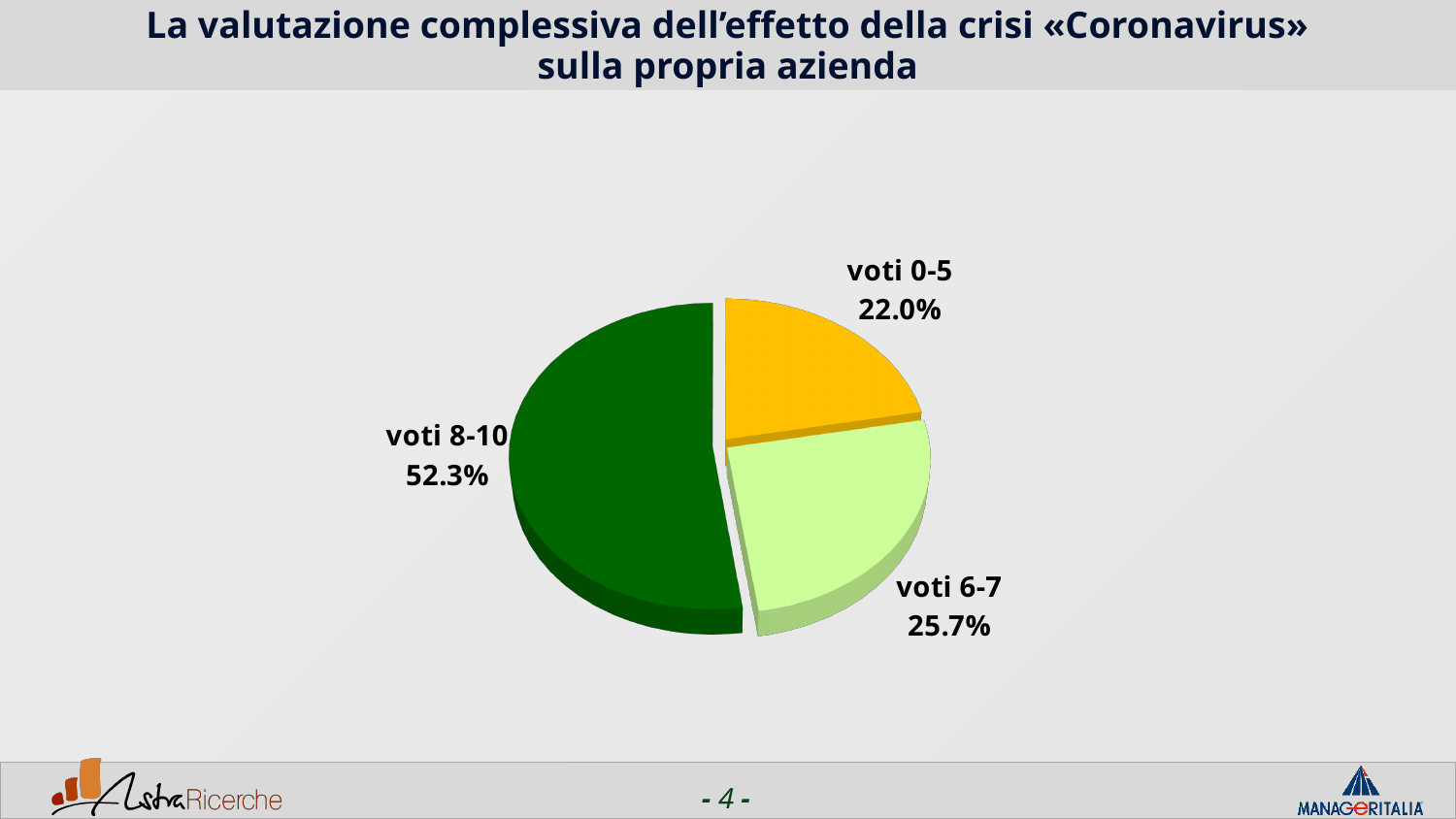
What is the difference between the shares for voti 6-7 and voti 0-5? 3.7% Which is larger, the share for voti 6-7 or the share for voti 0-5? voti 6-7 What colour is the slice for voti 8-10? dark green What is the title of the chart on the slide? La valutazione complessiva dell'effetto della crisi «Coronavirus» sulla propria azienda What is the difference between the shares for voti 8-10 and voti 6-7? 26.6% How many slices does the pie chart have? 3 Which category has the largest share of the pie? voti 8-10 Which category has the smallest share of the pie? voti 0-5 What type of chart is shown on the slide? pie chart What is the value for voti 8-10? 52.3% What is the value for voti 0-5? 22.0% What is the value for voti 6-7? 25.7%